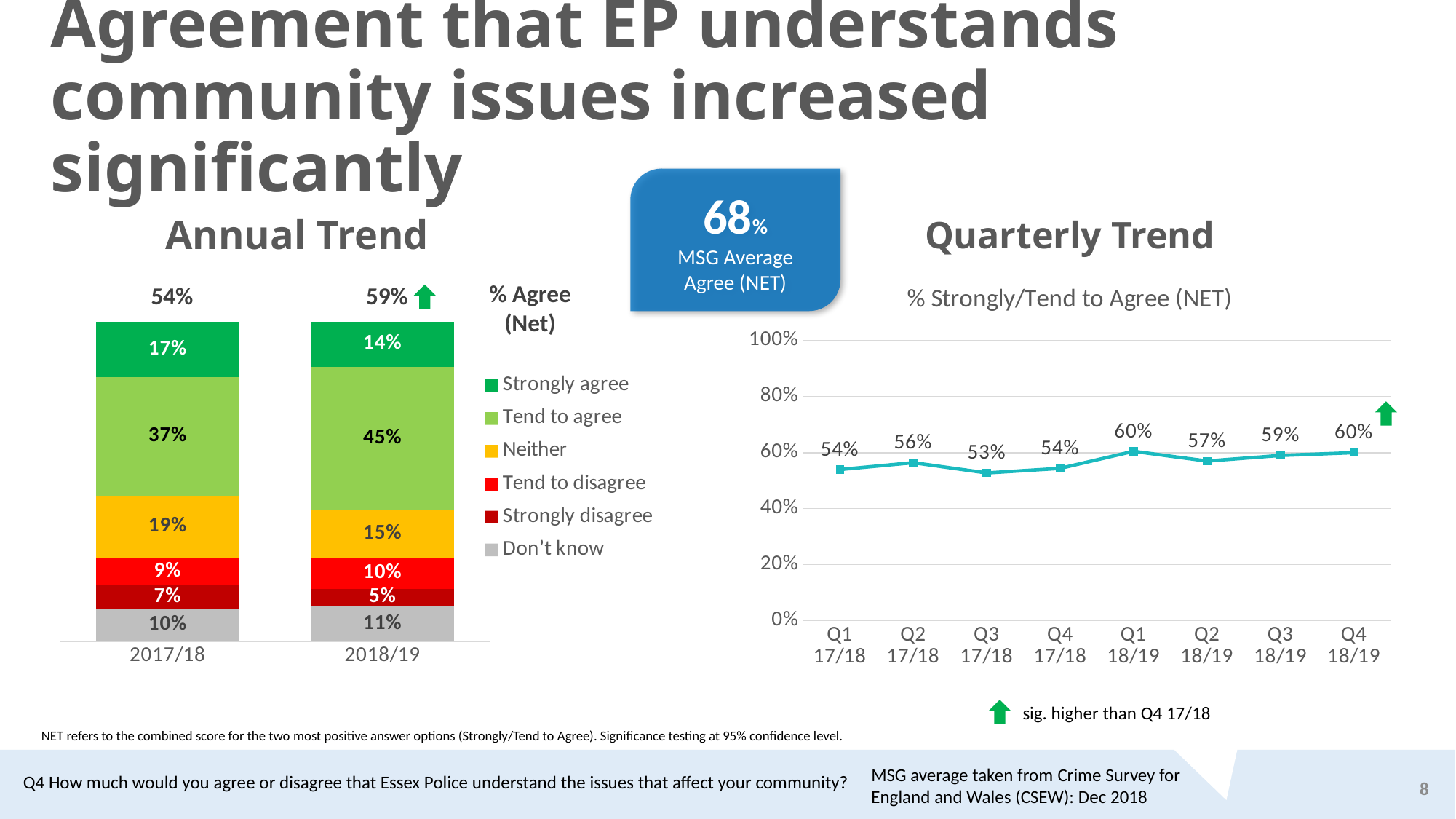
In the Quarterly Trend chart, what is the difference between Q4 18/19 and Q4 17/18? 6% In the Quarterly Trend chart, what is the value for Q3 18/19? 59% In the Annual Trend chart, what is the % Agree (Net) for 2018/19? 59% In the Annual Trend chart, what percentage of respondents said 'Tend to agree' in 2018/19? 45% What type of chart is the Annual Trend chart? Stacked bar chart In the Annual Trend chart, what is the 'Neither' value for 2017/18? 19% In the Quarterly Trend chart, how many quarters are plotted? 8 In the Quarterly Trend chart, which quarter has the lowest value? Q3 17/18 In the Annual Trend chart, what is the difference in 'Strongly agree' between 2017/18 and 2018/19? 3% How many series does the legend of the Annual Trend chart list? 6 What type of chart is the Quarterly Trend chart? Line chart In the Annual Trend chart, which year has the larger 'Strongly disagree' value, 2017/18 or 2018/19? 2017/18